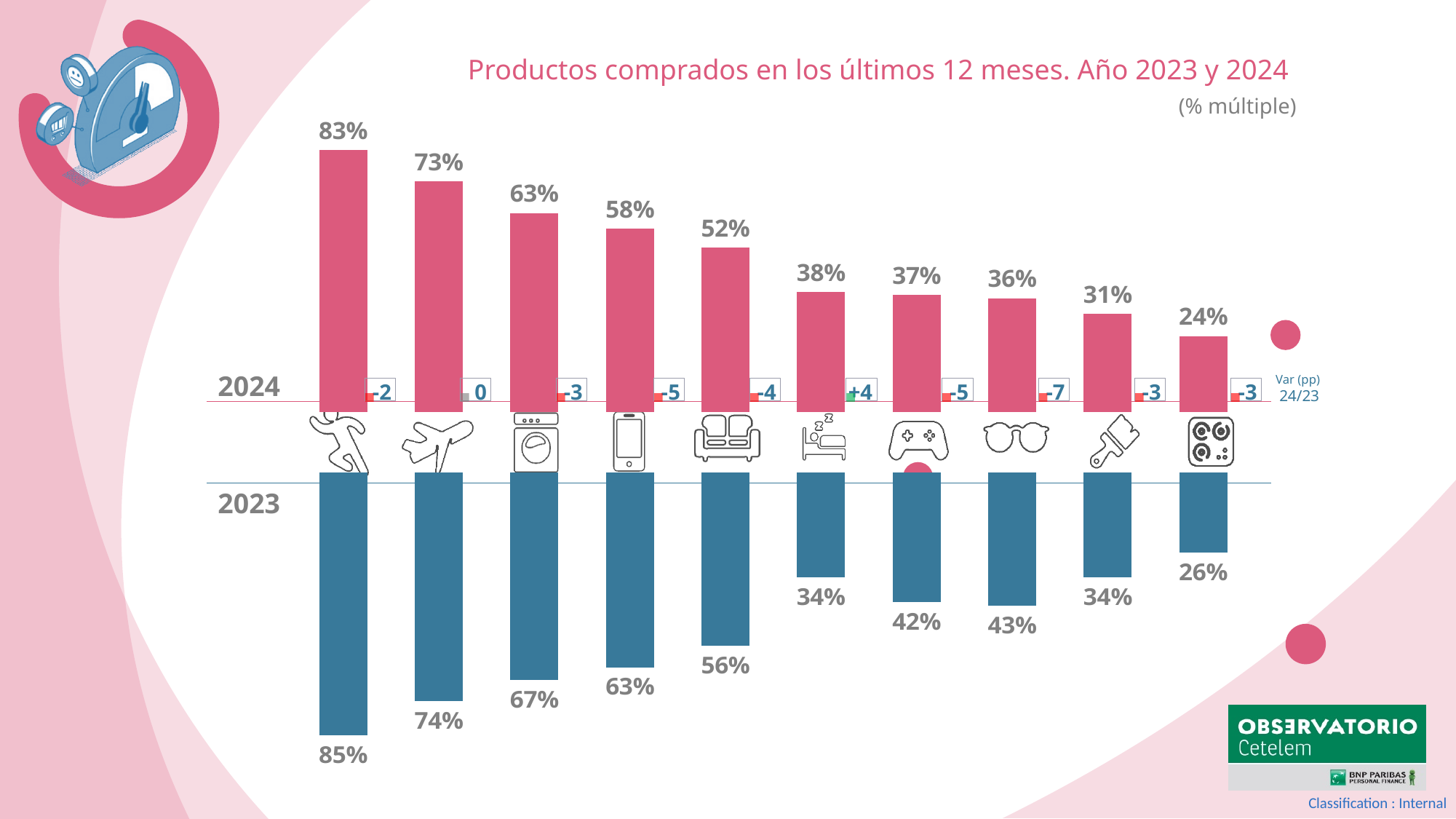
What is the 2023 value for the rightmost category (kitchen hob icon)? 26% What is the Var (pp) 24/23 value shown for the category with the bed icon (sixth from the left)? +4 What is the highest 2023 value shown in the chart? 85% Which colour is used for the 2024 bars and which for the 2023 bars? 2024 pink/red, 2023 blue What is the highest 2024 value shown in the chart? 83% What is the 2024 value for the category with the smartphone icon (fourth from the left)? 58% Do the 2024 values rise or fall from left to right across the chart? fall For the category with the airplane icon, which is larger: the 2024 value or the 2023 value? 2023 (74%) What is the title of the chart? Productos comprados en los últimos 12 meses. Año 2023 y 2024 What kind of chart is shown on the slide? bar chart How many product categories are plotted in the chart? 10 What is the lowest 2024 value shown in the chart? 24%